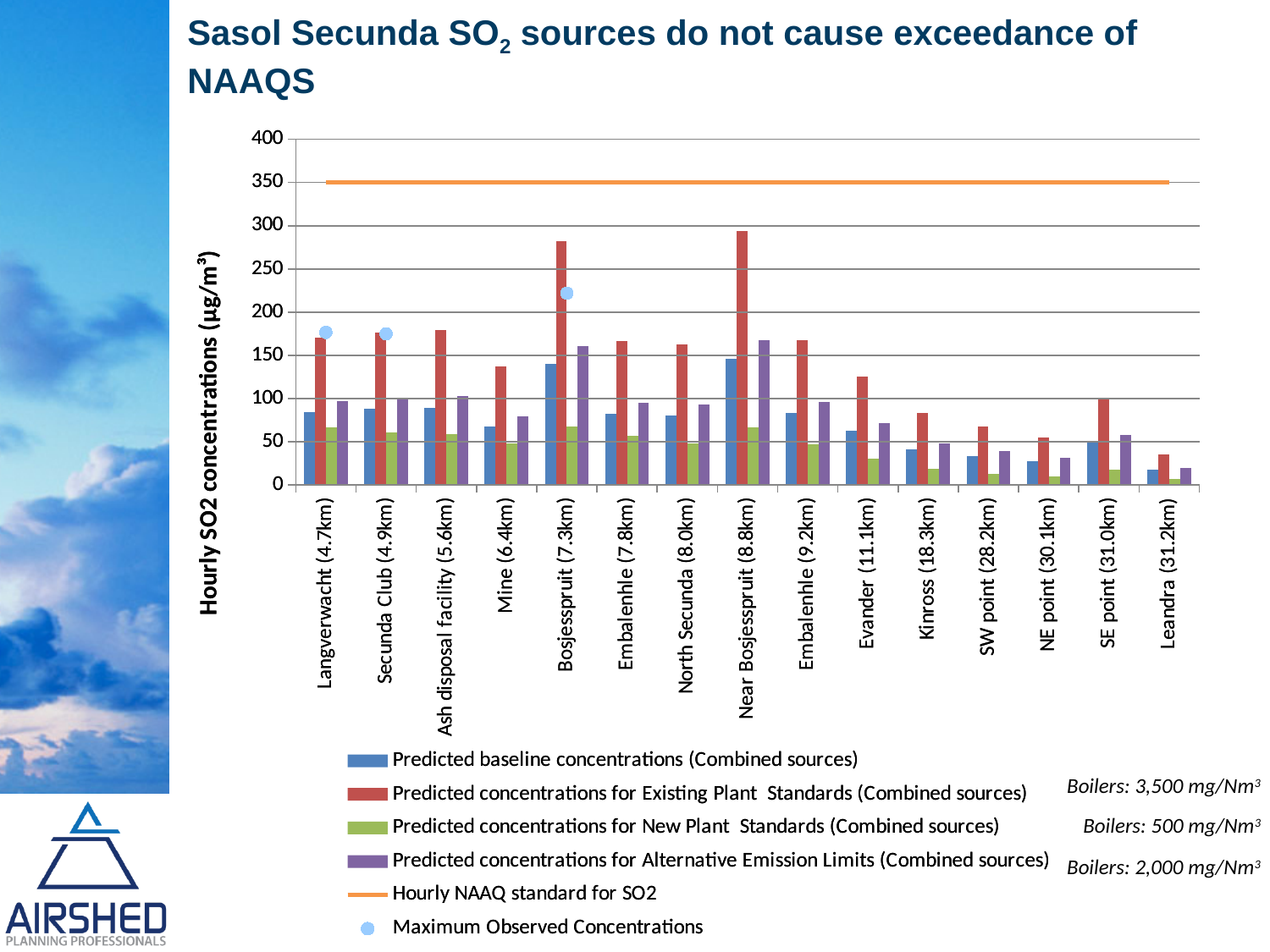
How many entries does the chart legend list? 6 At what value does the Hourly NAAQ standard for SO2 line sit on the chart? 350 Is the Predicted concentrations for Existing Plant Standards value for Evander (11.1km) greater or less than 100? greater Which location has the highest Predicted concentrations for Existing Plant Standards (Combined sources)? Near Bosjesspruit (8.8km) What colour is the Hourly NAAQ standard for SO2 line in the chart? orange What type of chart is shown on the slide? bar chart Is the Predicted concentrations for Existing Plant Standards value for Bosjesspruit (7.3km) greater or less than 250? greater Which is larger for Evander (11.1km): the Predicted concentrations for Alternative Emission Limits or the Predicted concentrations for New Plant Standards? Predicted concentrations for Alternative Emission Limits How many locations are shown along the x axis of the chart? 15 Is the Predicted concentrations for Existing Plant Standards value for Kinross (18.3km) greater or less than 100? less Which location has the lowest Predicted baseline concentrations (Combined sources)? Leandra (31.2km) Which location has the lowest Predicted concentrations for Existing Plant Standards (Combined sources)? Leandra (31.2km)